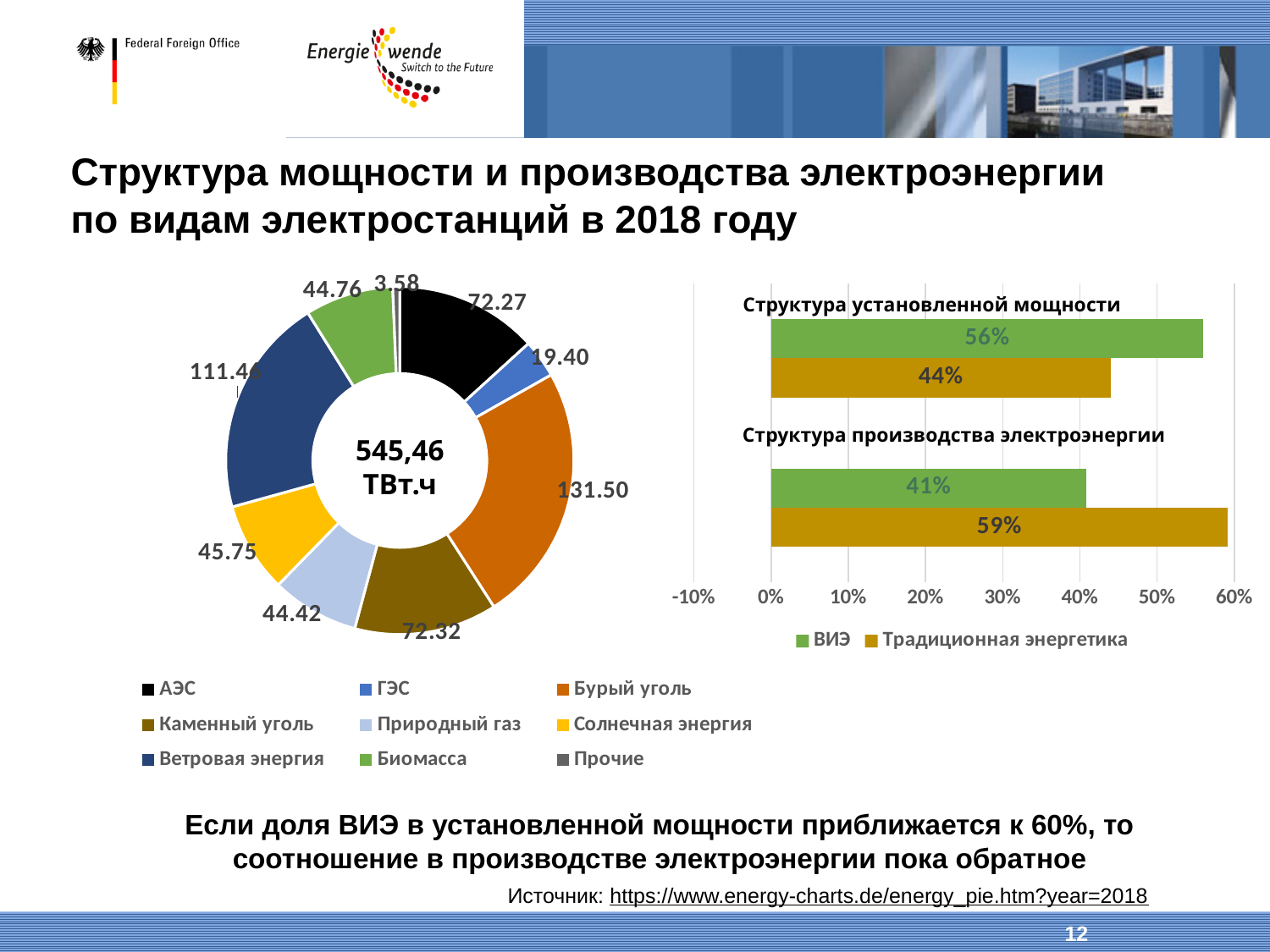
In the doughnut chart on the left, which category has the smallest value? Прочие In the doughnut chart on the left, what is the difference between Солнечная энергия and Природный газ? 1.33 In the bar chart on the right, what is the difference between Традиционная энергетика and ВИЭ in Структура производства электроэнергии? 18% In the bar chart on the right, what is the share of ВИЭ in Структура установленной мощности? 56% In the doughnut chart on the left, what is the value for Бурый уголь? 131.50 How many categories does the legend of the doughnut chart on the left list? 9 What kind of chart is the chart on the left of the slide? Doughnut (pie) chart In the bar chart on the right, what is the share of Традиционная энергетика in Структура производства электроэнергии? 59% In the doughnut chart on the left, which category has the largest value? Бурый уголь In the doughnut chart on the left, what total is shown in the centre of the ring? 545,46 ТВт.ч In the doughnut chart on the left, what is the value for ГЭС? 19.40 How many series does the legend of the bar chart on the right list? 2